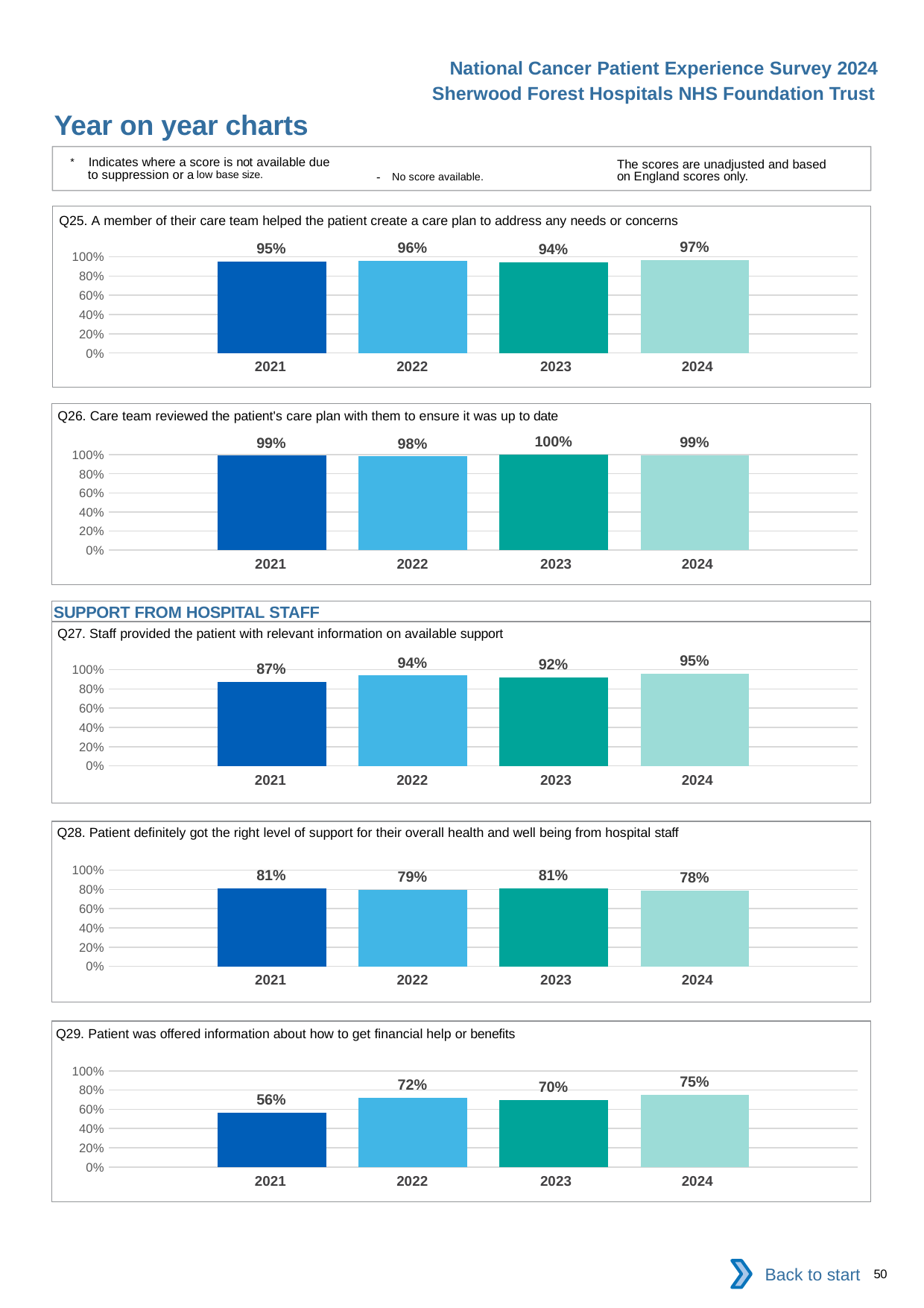
In the Q25 chart, which year has the lowest value? 2023 In the Q28 chart, what is the value for 2021? 81% In the Q29 chart, which year has the lowest value? 2021 In the Q26 chart, what is the value for 2023? 100% In the Q25 chart, what is the value for 2024? 97% In the Q26 chart, what is the difference between the 2023 and 2022 values? 2% How many years are shown in the Q29 chart? 4 In the Q28 chart, which is larger, the value for 2022 or the value for 2024? 2022 What kind of chart is the Q25 chart? Bar chart In the Q29 chart, what is the difference between the 2024 and 2021 values? 19% In the Q27 chart, what is the difference between the 2024 and 2021 values? 8% In the Q27 chart, which year has the highest value? 2024